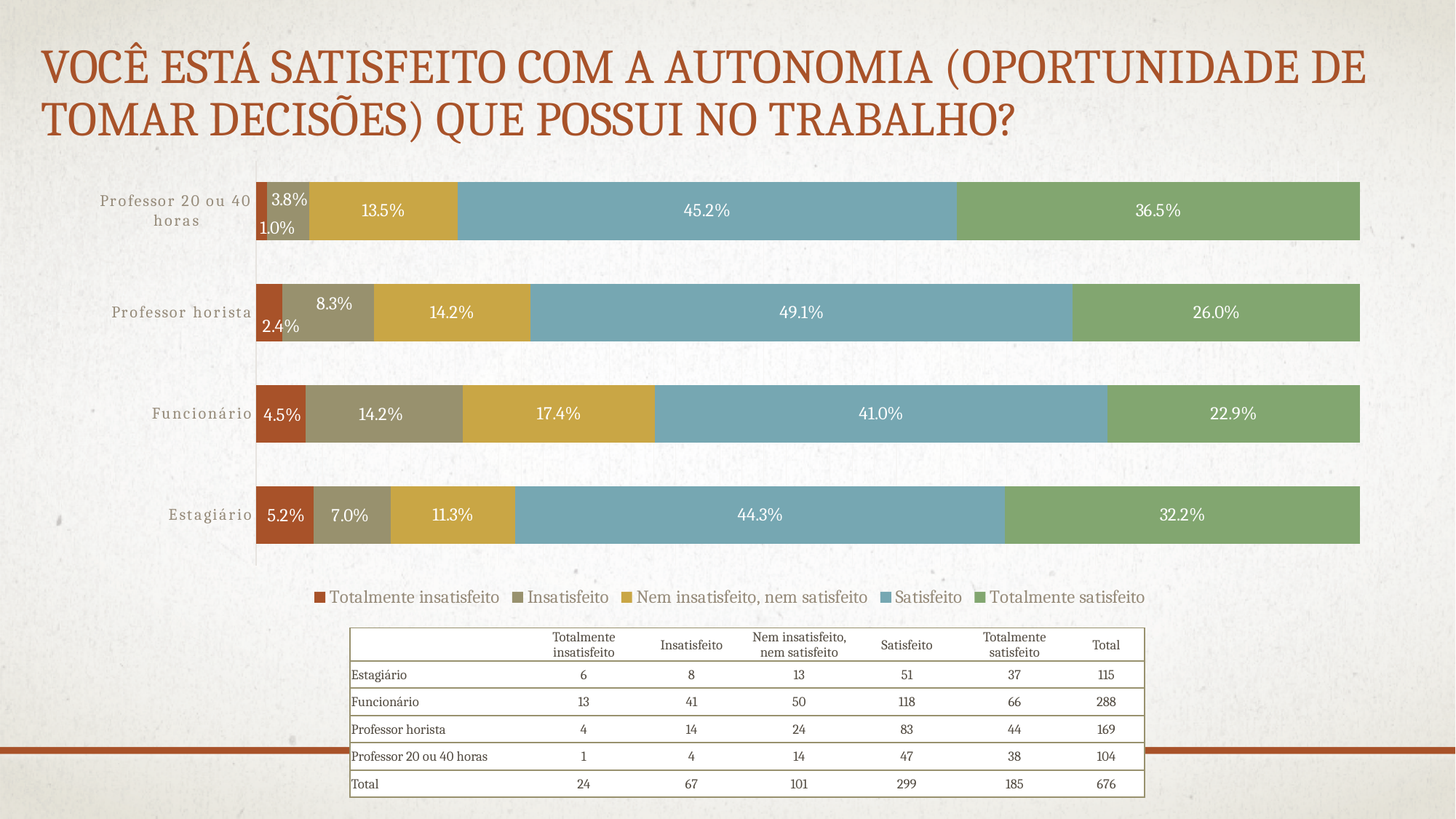
Which is larger, the Nem insatisfeito, nem satisfeito value for Funcionário or for Professor horista? Funcionário What is the difference between the Totalmente satisfeito values for Estagiário and Funcionário? 9.3 percentage points What is the value for Satisfeito in the Funcionário bar? 41.0% How many categories (bars) does the chart show? 4 Which category has the highest Satisfeito value? Professor horista Which category has the lowest Totalmente insatisfeito value? Professor 20 ou 40 horas What is the value for Totalmente satisfeito in the Professor 20 ou 40 horas bar? 36.5% How many series does the legend list? 5 What is the value for Insatisfeito in the Estagiário bar? 7.0% Which category has the highest Totalmente satisfeito value? Professor 20 ou 40 horas What kind of chart is shown on the slide? Stacked bar chart What colour represents Satisfeito in the chart? Blue